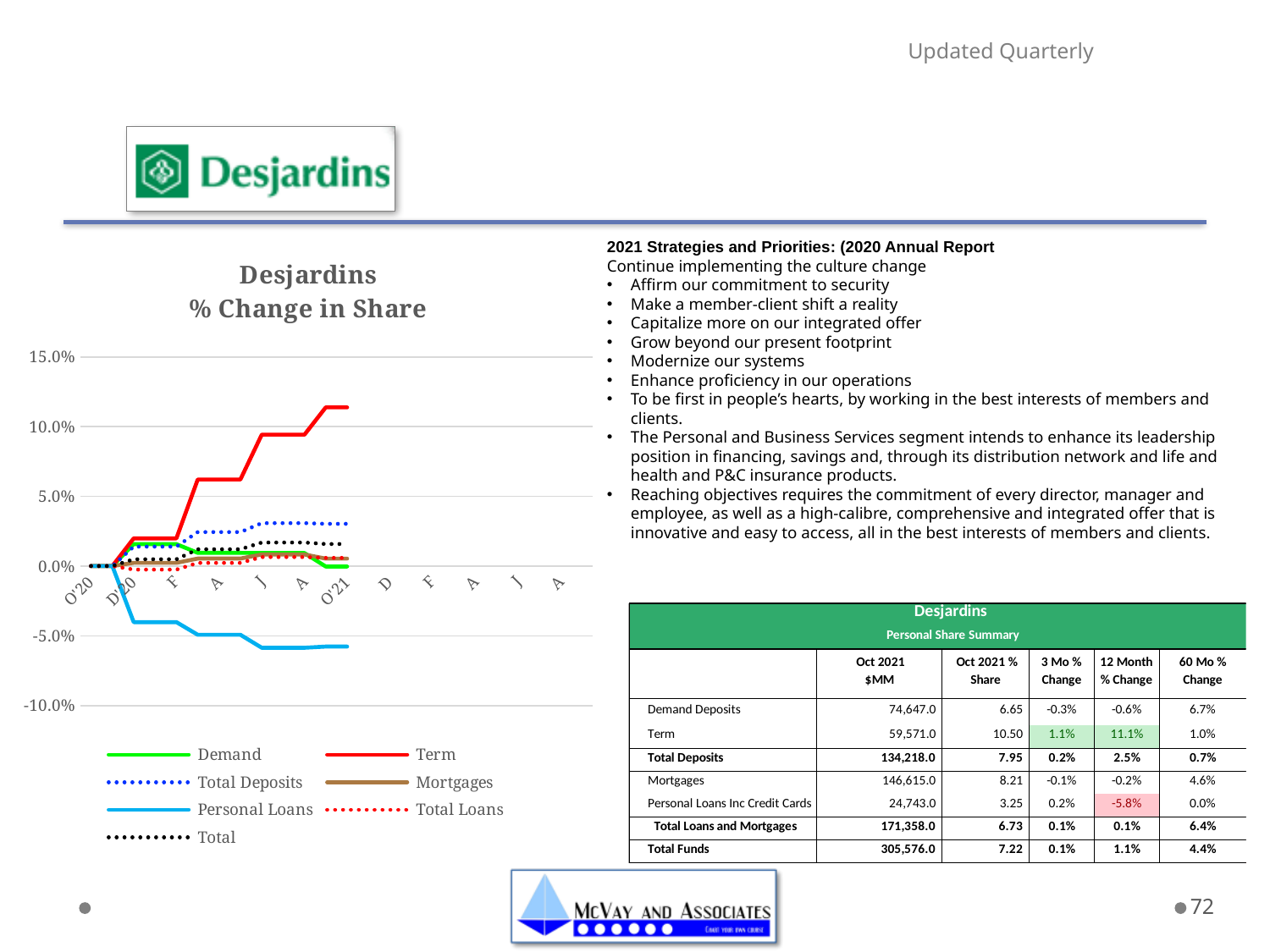
Is the value for Personal Loans at O'21 greater or less than -5.0%? less Which series has the highest value at O'21? Term Is the value for Total Deposits at O'21 greater or less than 5.0%? less What kind of chart is shown on the slide? line chart At O'21, which is larger: the value for Term or the value for Personal Loans? Term Does the Personal Loans series rise or fall from O'20 to O'21? fall What is the title of the chart? Desjardins % Change in Share Is the value for Term at O'21 greater or less than 10.0%? greater What colour is the Term line in the chart? red Which series has the lowest value at O'21? Personal Loans How many series does the chart legend list? 7 Does the Term series rise or fall from O'20 to O'21? rise